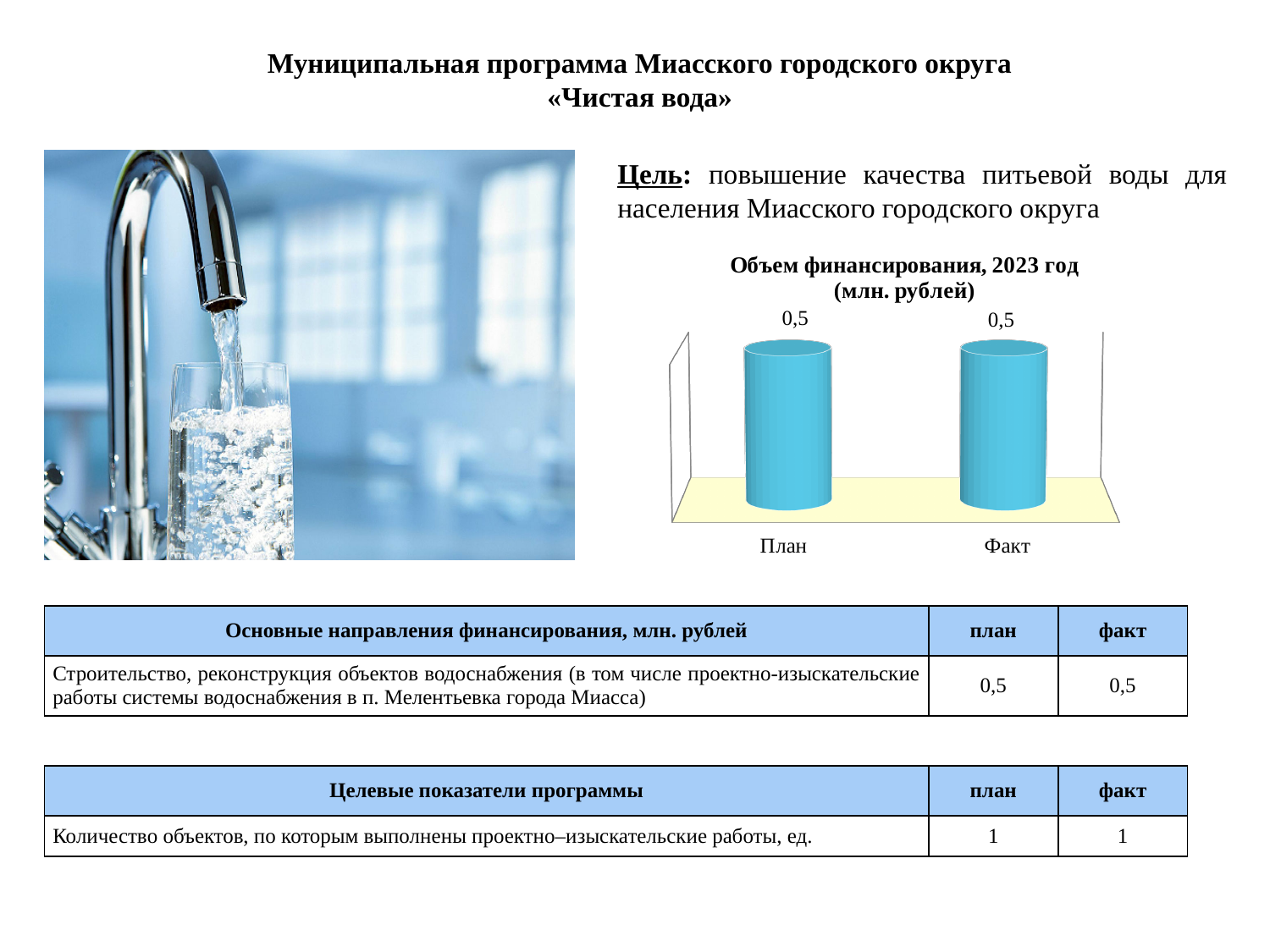
What kind of chart is shown on the slide? Bar chart Are the values for План and Факт in the chart equal? Yes What is the difference between the План and Факт values in the chart? 0 What are the category labels on the x axis of the chart? План, Факт What is the value for План in the chart? 0,5 How many categories are shown in the chart? 2 What is the value for Факт in the chart? 0,5 Is the value for План in the chart greater or less than 1? less What is the title of the chart? Объем финансирования, 2023 год (млн. рублей) Do the values rise, fall or stay the same from План to Факт in the chart? Stay the same